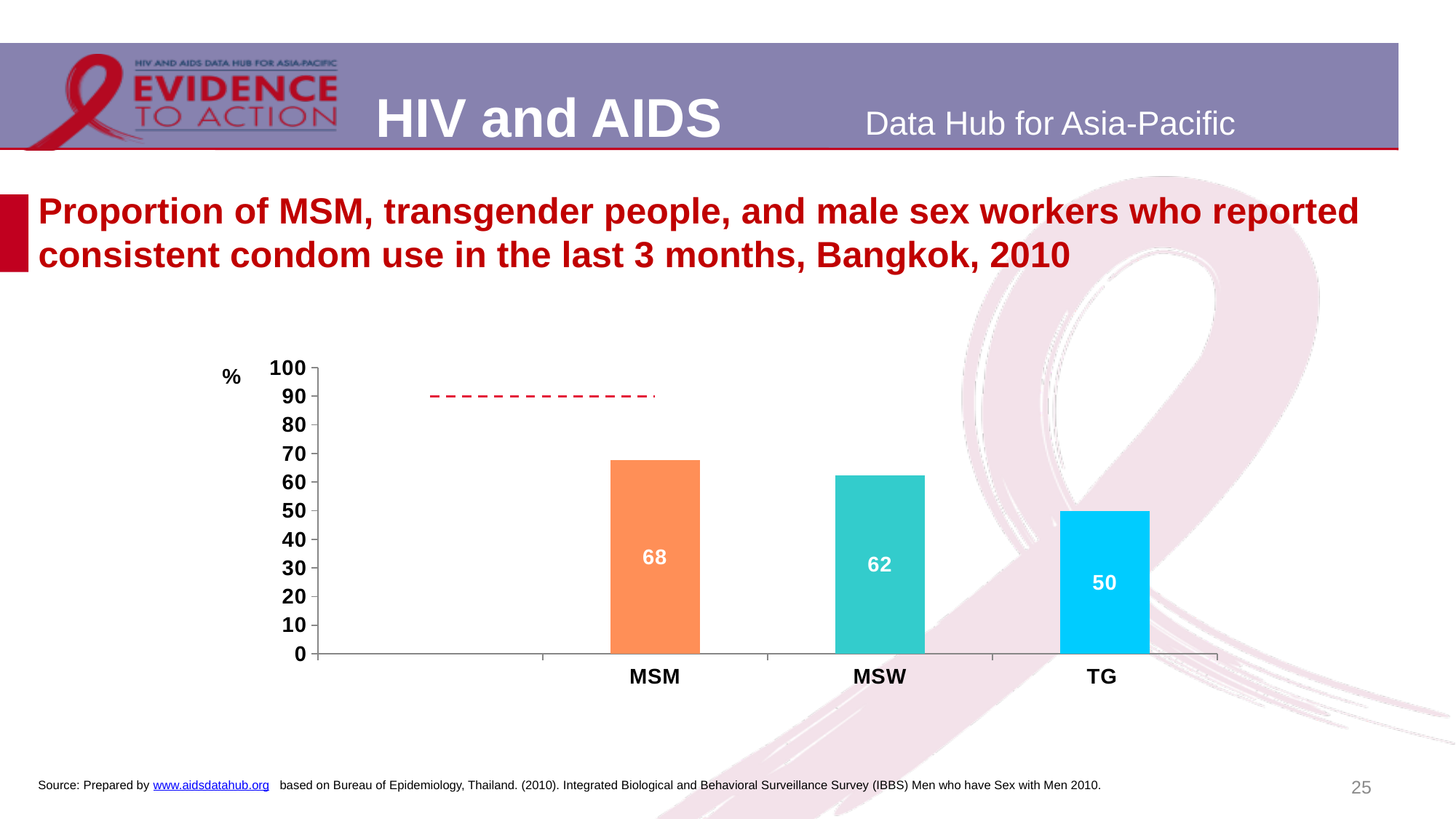
What is the difference between the values for MSM and MSW? 6 What is the value for MSW? 62 How many categories are shown on the x axis? 3 Do the values rise or fall from MSM to TG along the x axis? fall What is the value for TG? 50 What is the value for MSM? 68 Is the value for MSW greater or less than 70? less What is the difference between the values for MSM and TG? 18 Which category has the lowest value? TG Which is larger, the value for MSW or the value for TG? MSW What kind of chart is shown on the slide? bar chart Which category has the highest value? MSM